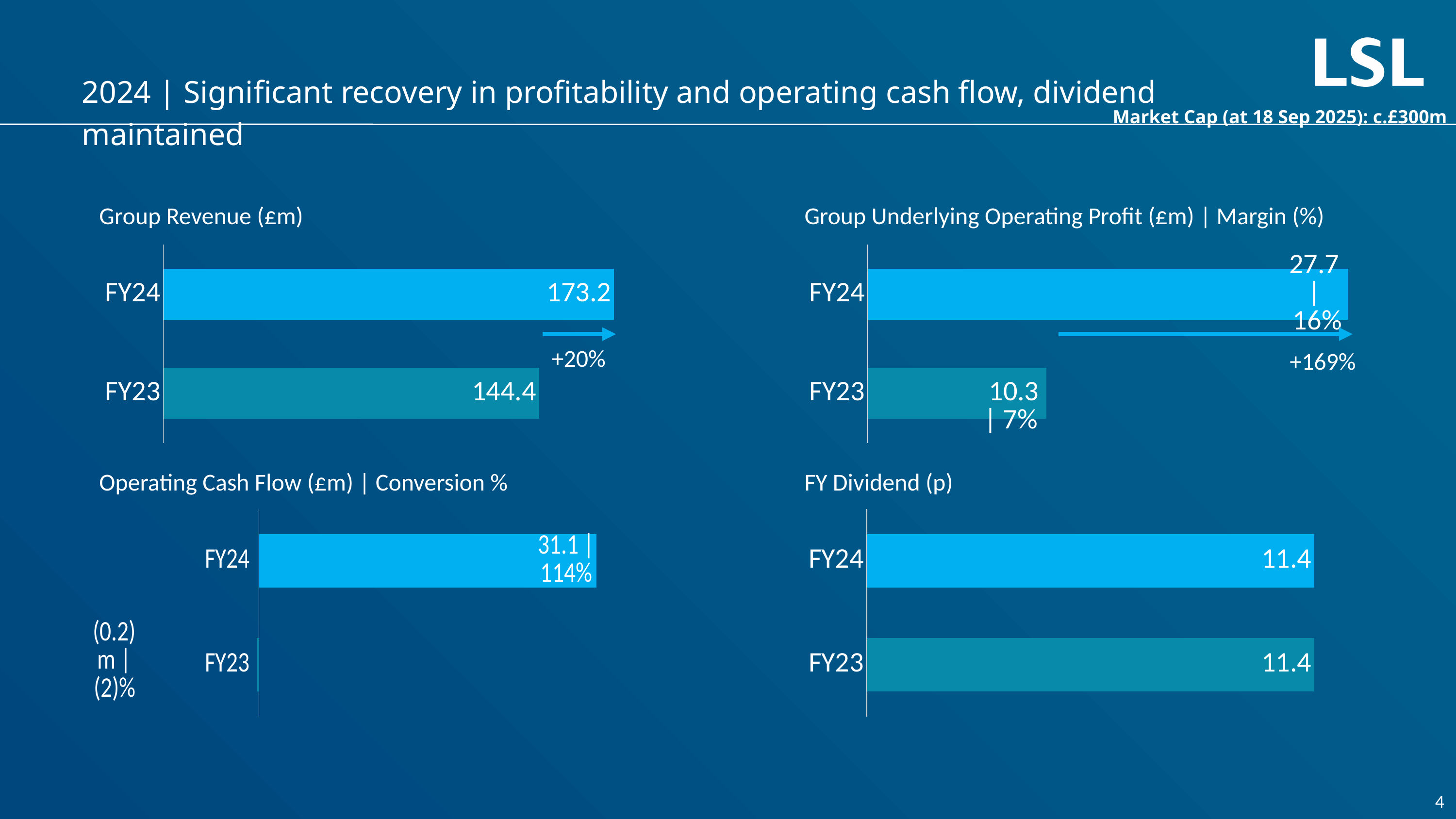
In the Operating Cash Flow (£m) | Conversion % chart, what is the operating cash flow for FY23? (0.2) In the FY Dividend (p) chart, what is the value for FY23? 11.4 What kind of chart is the Group Revenue (£m) chart? Bar chart How many bars does the FY Dividend (p) chart show? 2 In the Group Underlying Operating Profit (£m) | Margin (%) chart, which year has the higher operating profit, FY24 or FY23? FY24 In the Group Revenue (£m) chart, what is the value for FY24? 173.2 In the Operating Cash Flow (£m) | Conversion % chart, what is the operating cash flow for FY24? 31.1 In the Group Revenue (£m) chart, what is the value for FY23? 144.4 In the Group Underlying Operating Profit (£m) | Margin (%) chart, what margin is shown for FY23? 7% In the Operating Cash Flow (£m) | Conversion % chart, what conversion percentage is shown for FY24? 114% In the Group Underlying Operating Profit (£m) | Margin (%) chart, what is the operating profit for FY24? 27.7 In the Group Revenue (£m) chart, what is the difference between the FY24 and FY23 values? 28.8